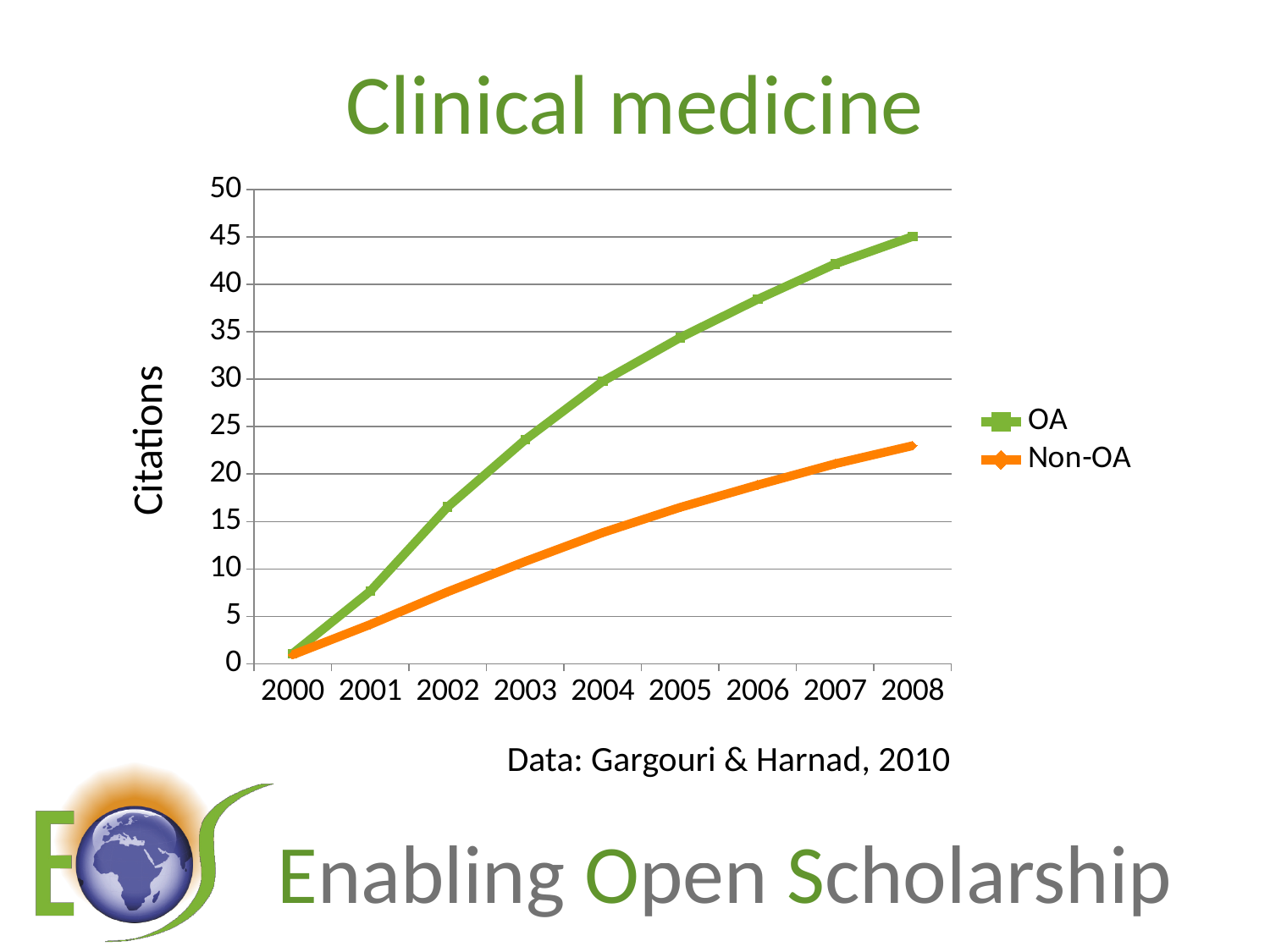
Is the OA value for 2003 greater or less than 20? greater In which year is the Non-OA series at its lowest? 2000 Is the OA value for 2004 greater or less than 25? greater How many series does the legend list? 2 Do the OA citations rise or fall from 2000 to 2008? rise Is the Non-OA value for 2008 greater or less than 25? less In which year is the OA series at its highest? 2008 How many years are shown on the x axis? 9 In 2008, which series has more citations, OA or Non-OA? OA What kind of chart is shown on the slide? line chart What is the label on the y axis? Citations